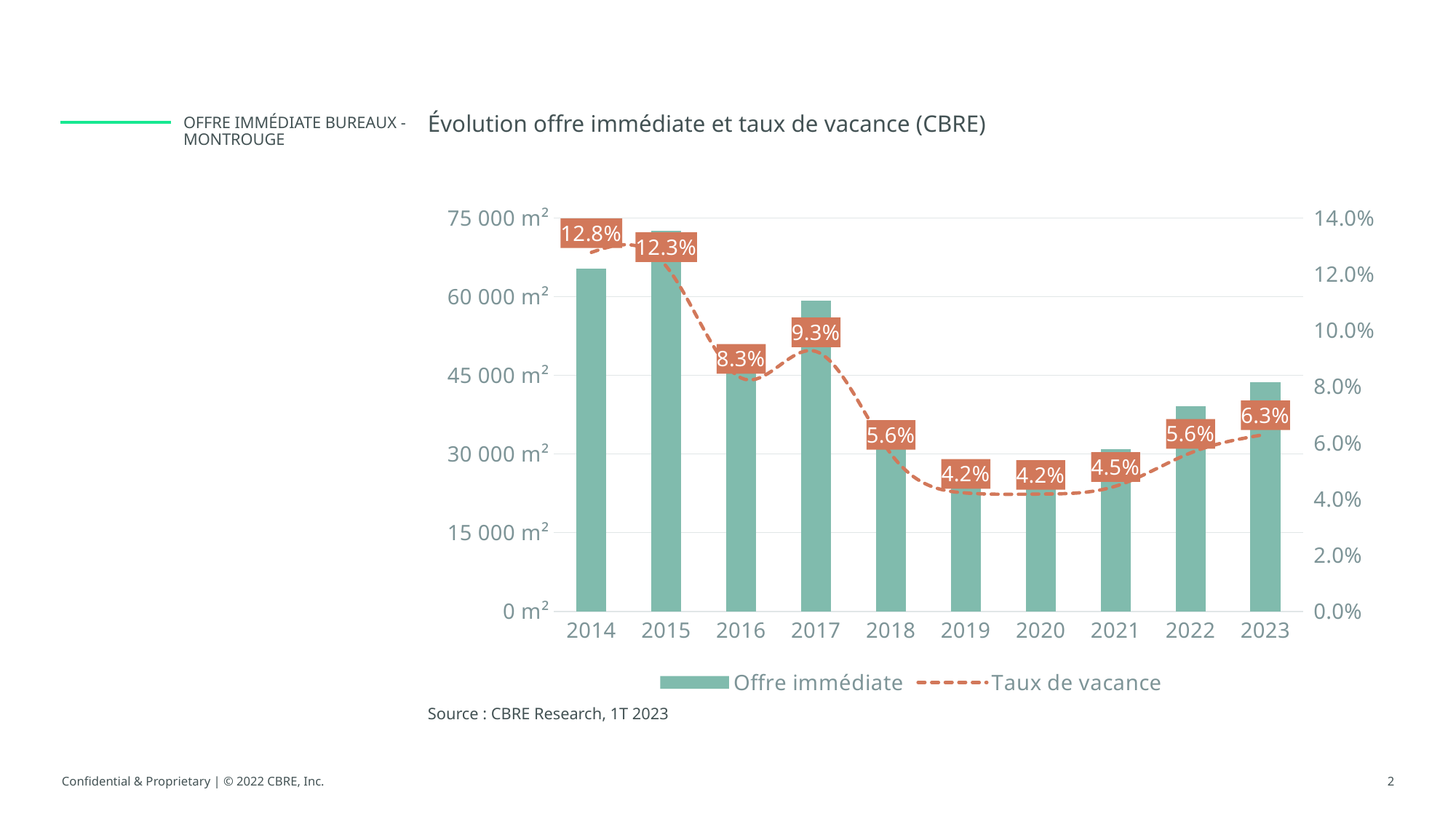
How many years are shown on the x axis? 10 In which year is the Offre immédiate bar the tallest? 2015 What is the vacancy rate (Taux de vacance) shown for 2017? 9.3% How many series does the legend list? 2 Is the Offre immédiate value for 2015 greater or less than 60 000 m²? greater Does the vacancy rate rise or fall from 2014 to 2019? fall In which year is the vacancy rate (Taux de vacance) highest? 2014 By how many percentage points does the vacancy rate differ between 2014 and 2015? 0.5% What is the vacancy rate (Taux de vacance) shown for 2023? 6.3% Is the Offre immédiate value for 2019 greater or less than 30 000 m²? less Which year has the higher vacancy rate, 2016 or 2017? 2017 What is the vacancy rate (Taux de vacance) shown for 2014? 12.8%